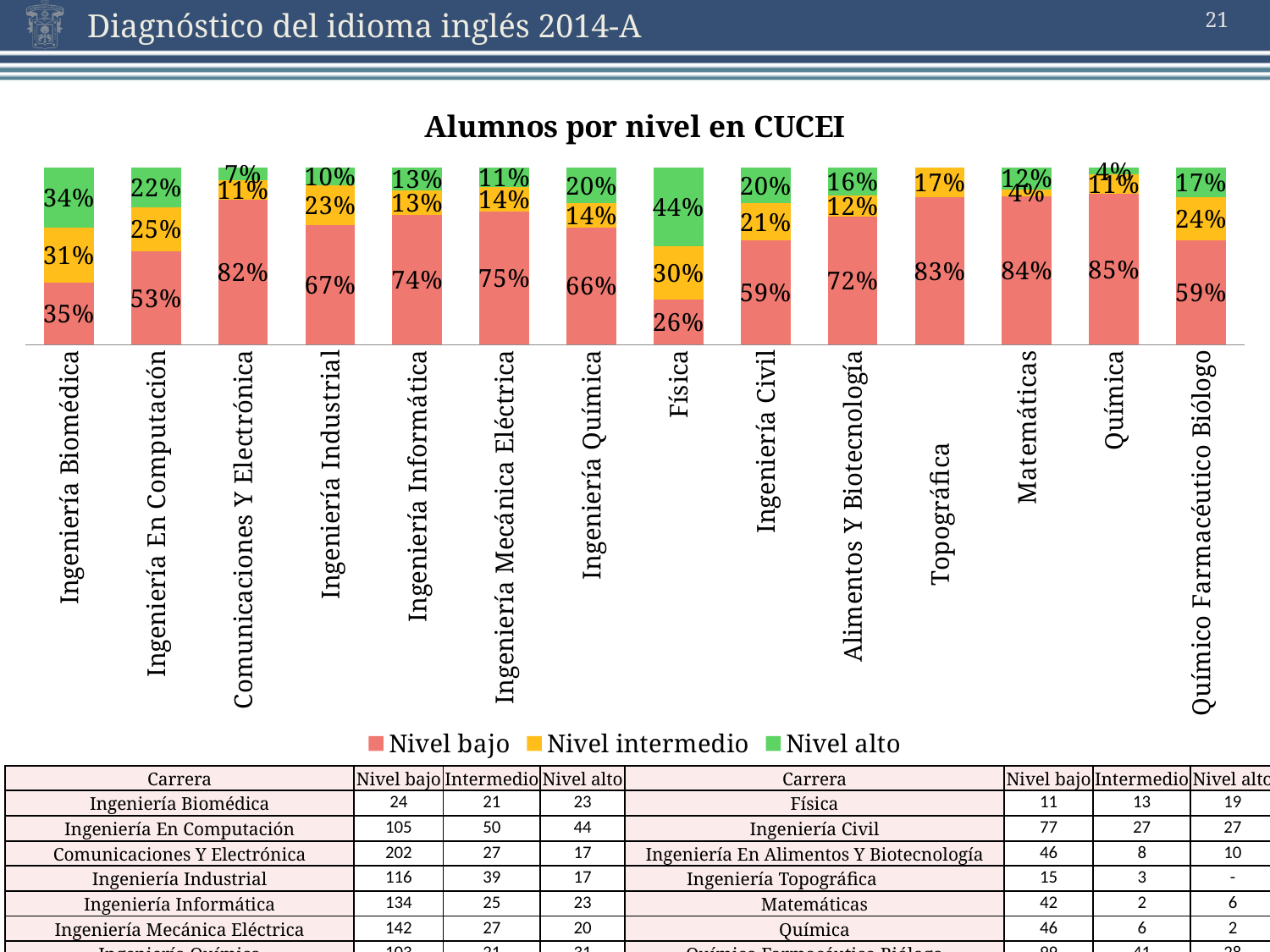
What is the Nivel bajo value for Ingeniería Industrial? 67% Which category has the highest Nivel alto value? Física How many categories (carreras) are shown on the x axis of the chart? 14 What is the title of the chart? Alumnos por nivel en CUCEI What is the Nivel alto value for Física? 44% Which category has the lowest Nivel bajo value? Física What kind of chart is shown on the slide? Stacked bar chart How many series does the legend list? 3 Which has a larger Nivel bajo value, Ingeniería Informática or Ingeniería Civil? Ingeniería Informática Which category has the highest Nivel bajo value? Química What is the difference in percentage points between the Nivel bajo values for Química and Física? 59 What is the Nivel intermedio value for Ingeniería En Computación? 25%